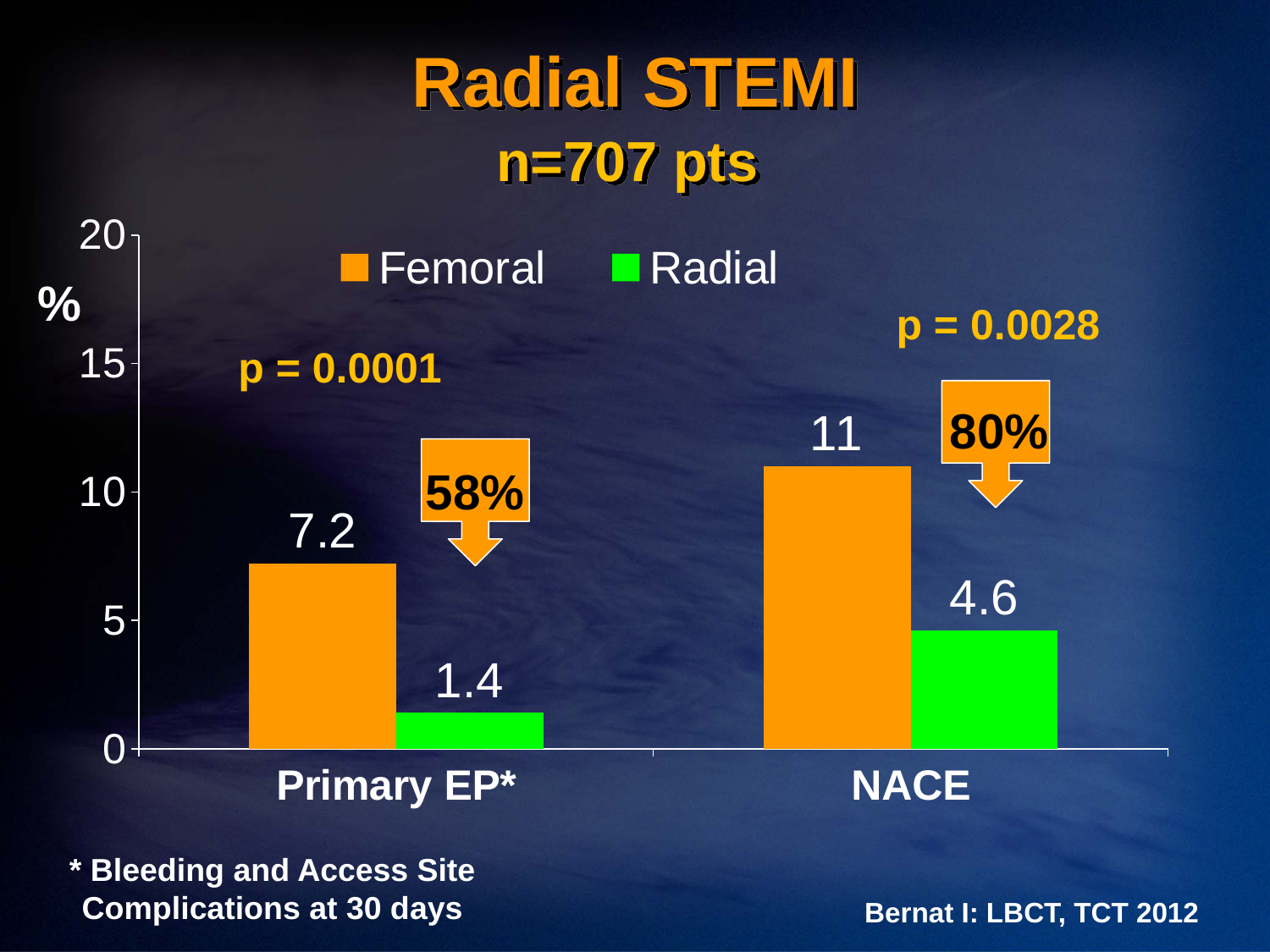
Which category has the highest Femoral value? NACE What is the Radial value for Primary EP*? 1.4 What is the p-value shown for the NACE comparison? p = 0.0028 What is the Femoral value for NACE? 11 What is the difference between the Femoral and Radial values for NACE? 6.4 What is the Femoral value for Primary EP*? 7.2 How many series does the legend list? 2 What kind of chart is shown on the slide? Bar chart What is the Radial value for NACE? 4.6 What is the difference between the Femoral and Radial values for Primary EP*? 5.8 Which category has the lowest Radial value? Primary EP* Which is larger for Primary EP*, the Femoral value or the Radial value? Femoral